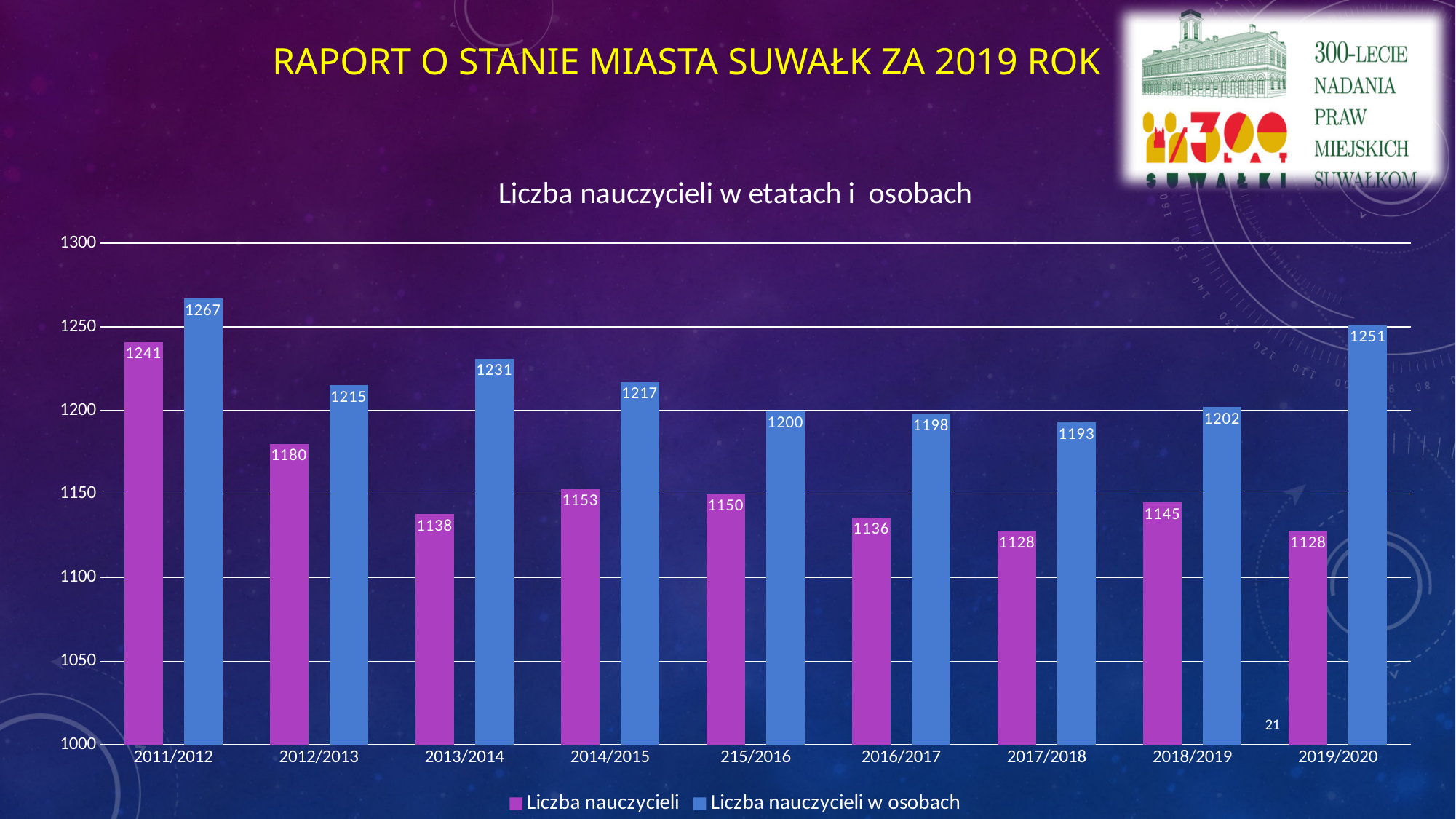
What is the value of Liczba nauczycieli w osobach for 2019/2020? 1251 How many school years are shown on the x axis? 9 How many series does the legend list? 2 Which is larger: Liczba nauczycieli in 2012/2013 or Liczba nauczycieli in 2018/2019? Liczba nauczycieli in 2012/2013 What type of chart is shown on the slide? Bar chart What is the difference between Liczba nauczycieli w osobach and Liczba nauczycieli in 2019/2020? 123 Which school year has the highest value for Liczba nauczycieli? 2011/2012 What is the value of Liczba nauczycieli w osobach for 2014/2015? 1217 Which school year has the highest value for Liczba nauczycieli w osobach? 2011/2012 What is the value of Liczba nauczycieli for 2011/2012? 1241 What is the value of Liczba nauczycieli for 2016/2017? 1136 Which school year has the lowest value for Liczba nauczycieli w osobach? 2017/2018